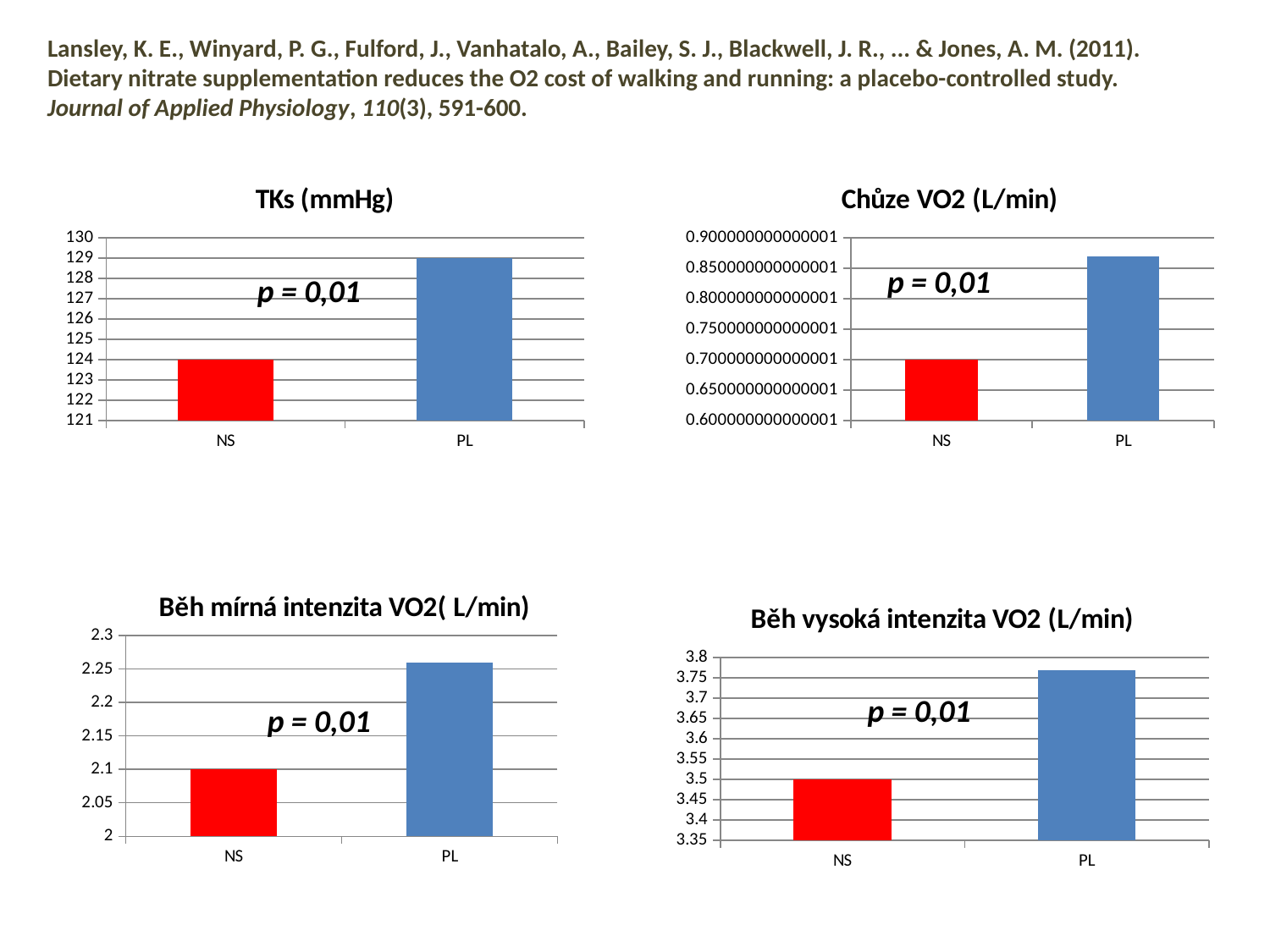
In the Běh mírná intenzita VO2 (L/min) chart, what is the value for NS? 2.1 How many categories are shown on the x axis of the Běh vysoká intenzita VO2 (L/min) chart? 2 In the TKs (mmHg) chart, what is the value for NS? 124 In the Běh vysoká intenzita VO2 (L/min) chart, what is the value for NS? 3.5 In the Chůze VO2 (L/min) chart, is the value for PL greater or less than 0.85? greater What kind of chart is the Chůze VO2 (L/min) chart? bar chart In the TKs (mmHg) chart, what is the difference between the PL and NS values? 5 In the TKs (mmHg) chart, which category has the higher value, NS or PL? PL In the Běh vysoká intenzita VO2 (L/min) chart, is the value for PL greater or less than 3.75? greater In the Chůze VO2 (L/min) chart, is the value for NS greater or less than 0.75? less In the TKs (mmHg) chart, what is the value for PL? 129